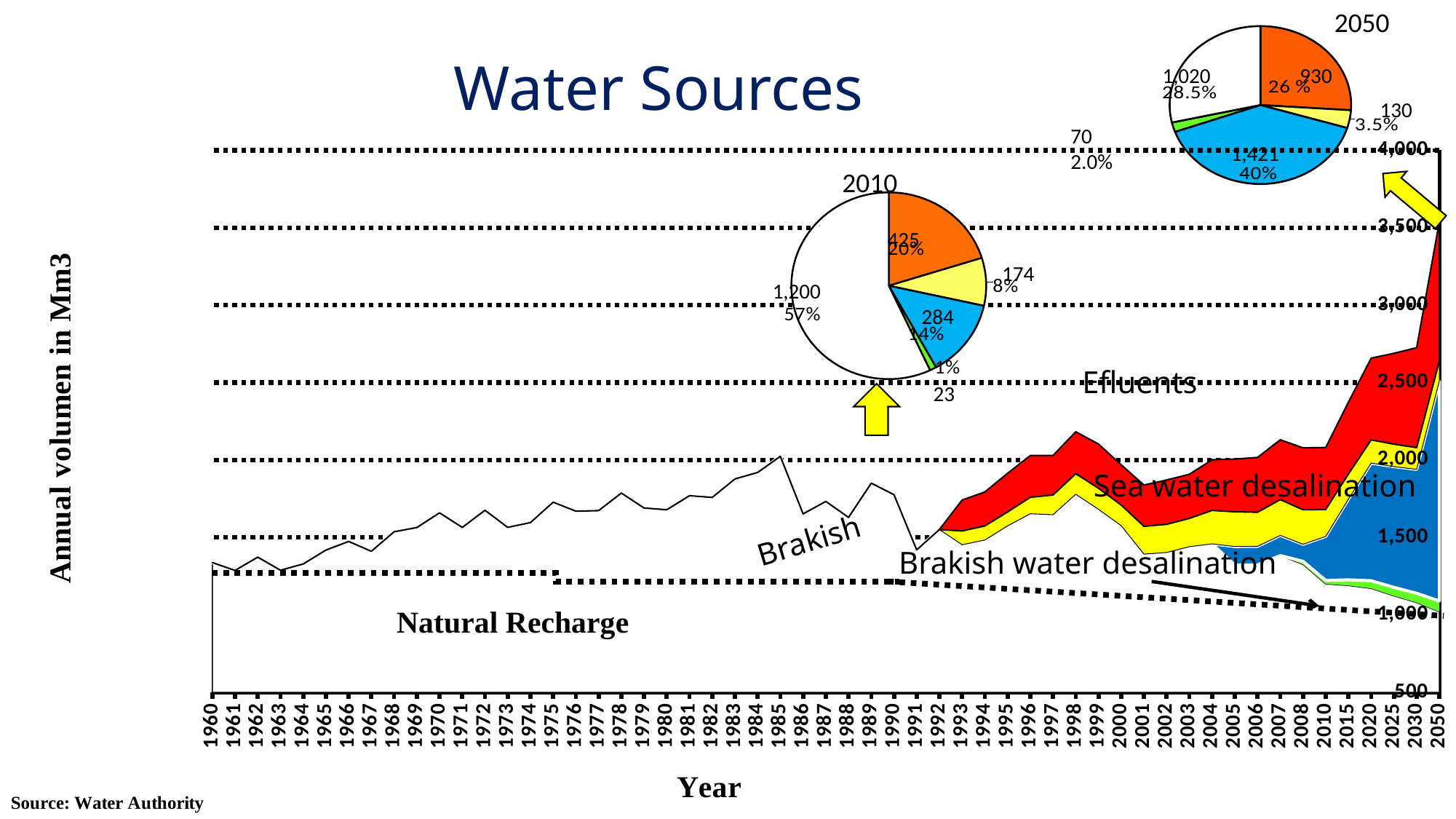
In the 2050 pie chart, which slice is larger: the one with value 1,020 or the one with value 930? 1,020 In the main chart, is the total annual volume in 1960 greater or less than 1,500? less In the 2010 pie chart, how many slices are there? 5 In the 2050 pie chart, what is the value of the slice labelled 3.5%? 130 In the 2050 pie chart, what is the value of the largest slice? 1,421 What is the title of the slide's main chart? Water Sources In the 2050 pie chart, what share does the slice with value 930 represent? 26 % What kind of chart is the main chart plotting annual volume against year? area chart In the 2010 pie chart, what share does the slice with value 1,200 represent? 57% What is the y-axis label of the main chart? Annual volumen in Mm3 In the 2010 pie chart, what is the value of the slice labelled 14%? 284 In the 2010 pie chart, what is the value of the smallest slice? 23